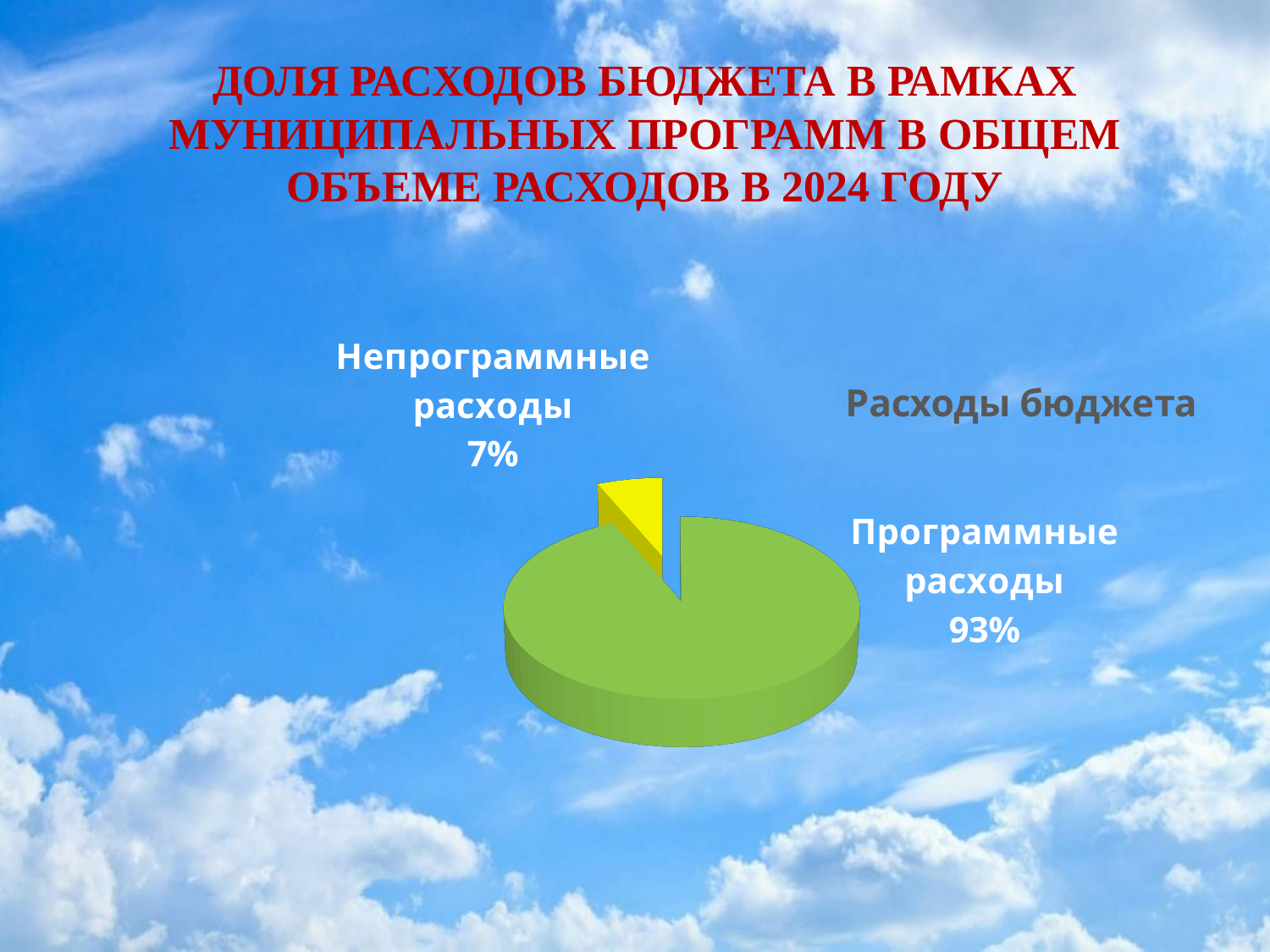
What kind of chart is shown on the slide? Pie chart Which is larger: the "Программные расходы" slice or the "Непрограммные расходы" slice? Программные расходы What is the total of the two slice percentages shown on the pie chart? 100% What is the difference in percentage points between the "Программные расходы" and "Непрограммные расходы" slices? 86 Which slice of the pie is the smallest? Непрограммные расходы What is the title of the chart? Расходы бюджета What share of the pie is labelled "Программные расходы"? 93% What colour is the "Непрограммные расходы" slice? Yellow How many slices does the pie chart have? 2 What share of the pie is labelled "Непрограммные расходы"? 7% Which slice of the pie is the largest? Программные расходы